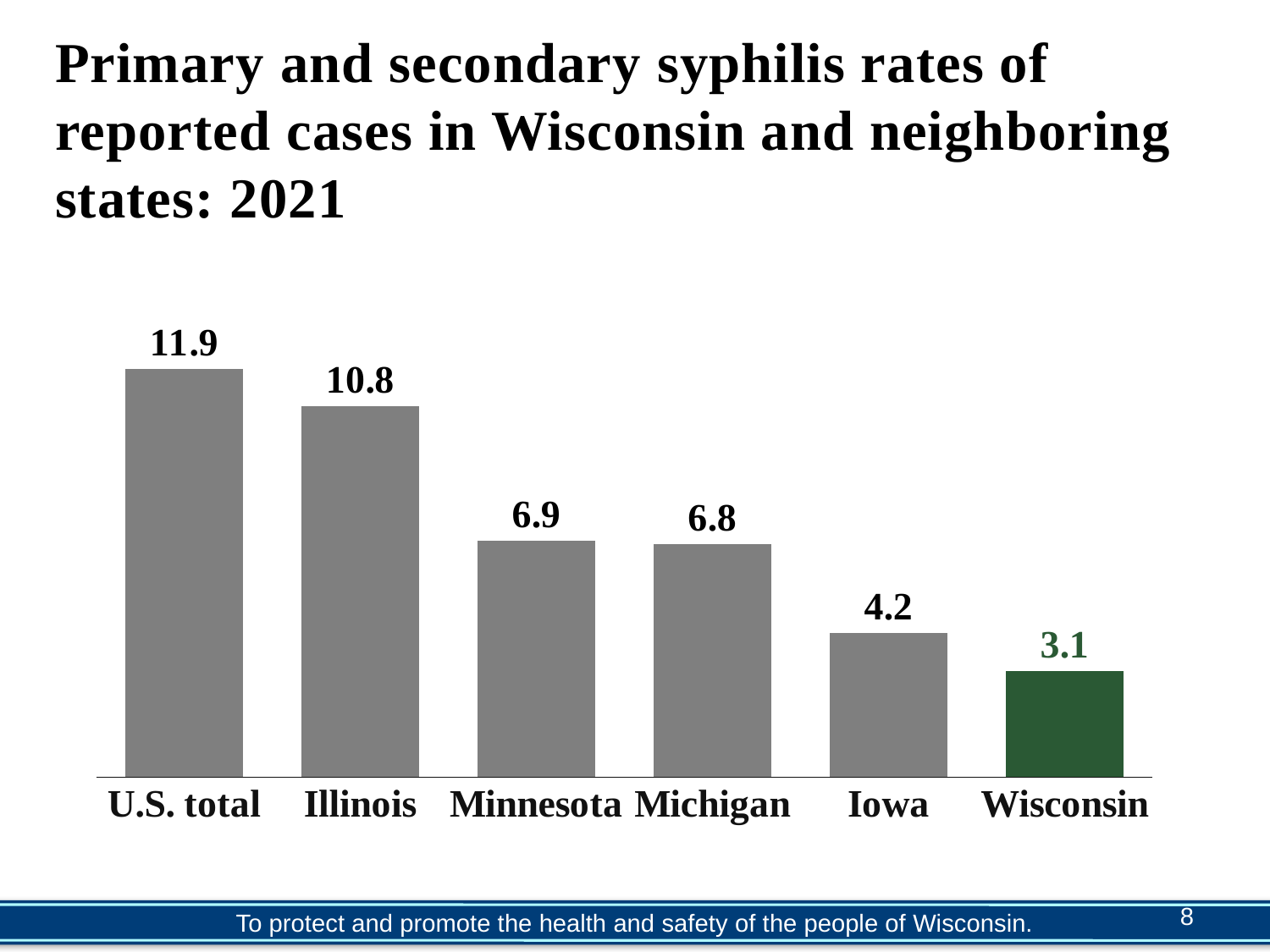
Which category has the highest rate? U.S. total Which bar is colored green rather than gray? Wisconsin Which has a higher rate, Illinois or Iowa? Illinois What is the difference between the rates for Iowa and Wisconsin? 1.1 Which state has the lowest rate? Wisconsin How many categories are shown on the chart? 6 What is the rate shown for Illinois? 10.8 What kind of chart is shown on the slide? Bar chart What is the rate shown for Minnesota? 6.9 What is the rate shown for the U.S. total? 11.9 What is the primary and secondary syphilis rate for Wisconsin? 3.1 What is the difference between the rates for Illinois and Wisconsin? 7.7